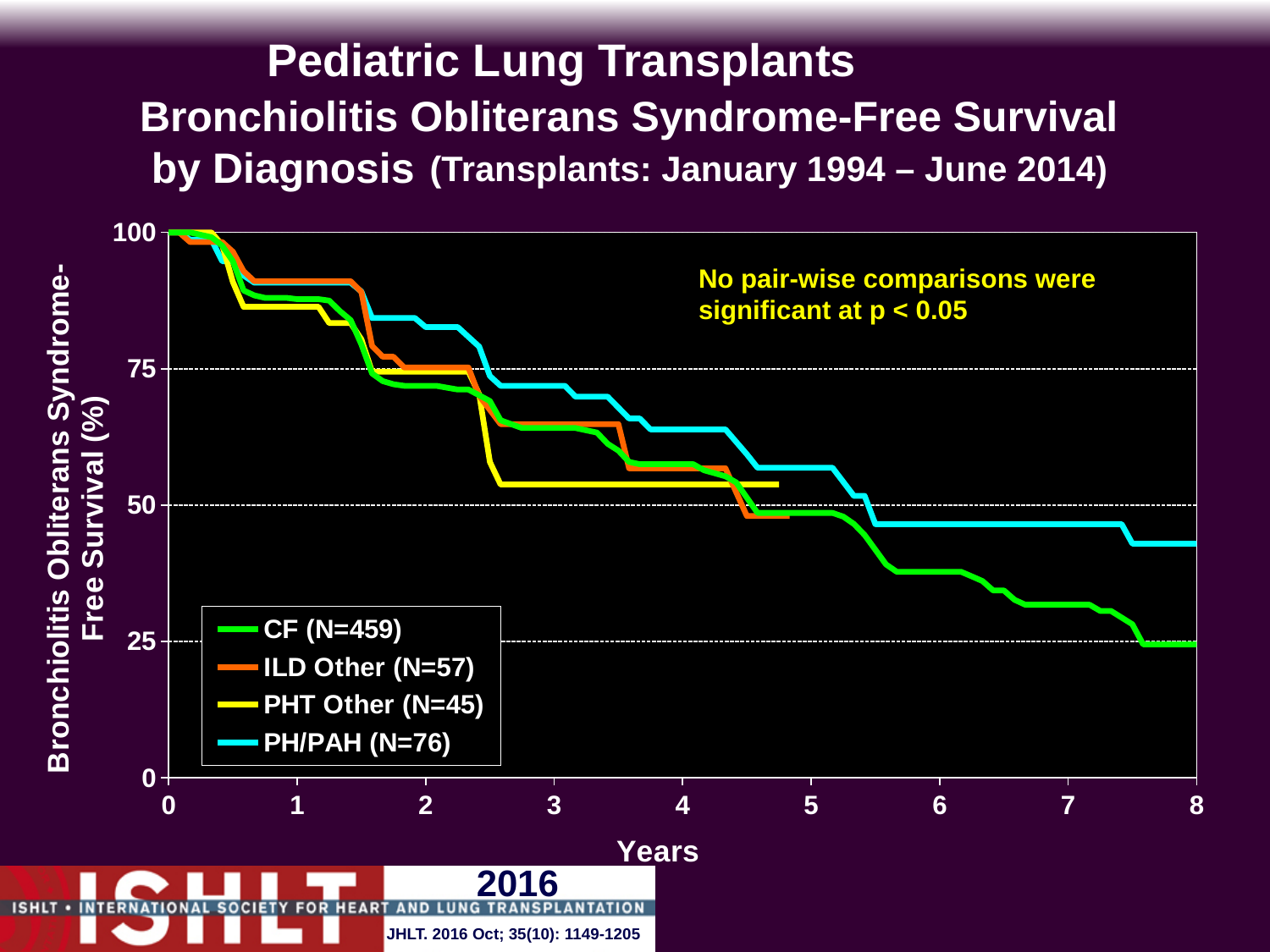
What is the N for the CF group shown in the legend? 459 What is the N for the ILD Other group shown in the legend? 57 Do the survival curves rise or fall as years increase? fall At 8 years, which group has higher BOS-free survival, CF or PH/PAH? PH/PAH How many diagnosis groups does the legend list? 4 What does the yellow annotation on the chart say about pair-wise comparisons? No pair-wise comparisons were significant at p < 0.05 Is the BOS-free survival for ILD Other at 1 year greater or less than 75%? greater Which diagnosis group has the largest N in the legend? CF (N=459) Is the BOS-free survival for PH/PAH at 8 years greater or less than 25%? greater What is the N for the PH/PAH group shown in the legend? 76 Is the BOS-free survival for CF at 8 years greater or less than 50%? less What kind of chart is shown on the slide? Line chart (survival curves)